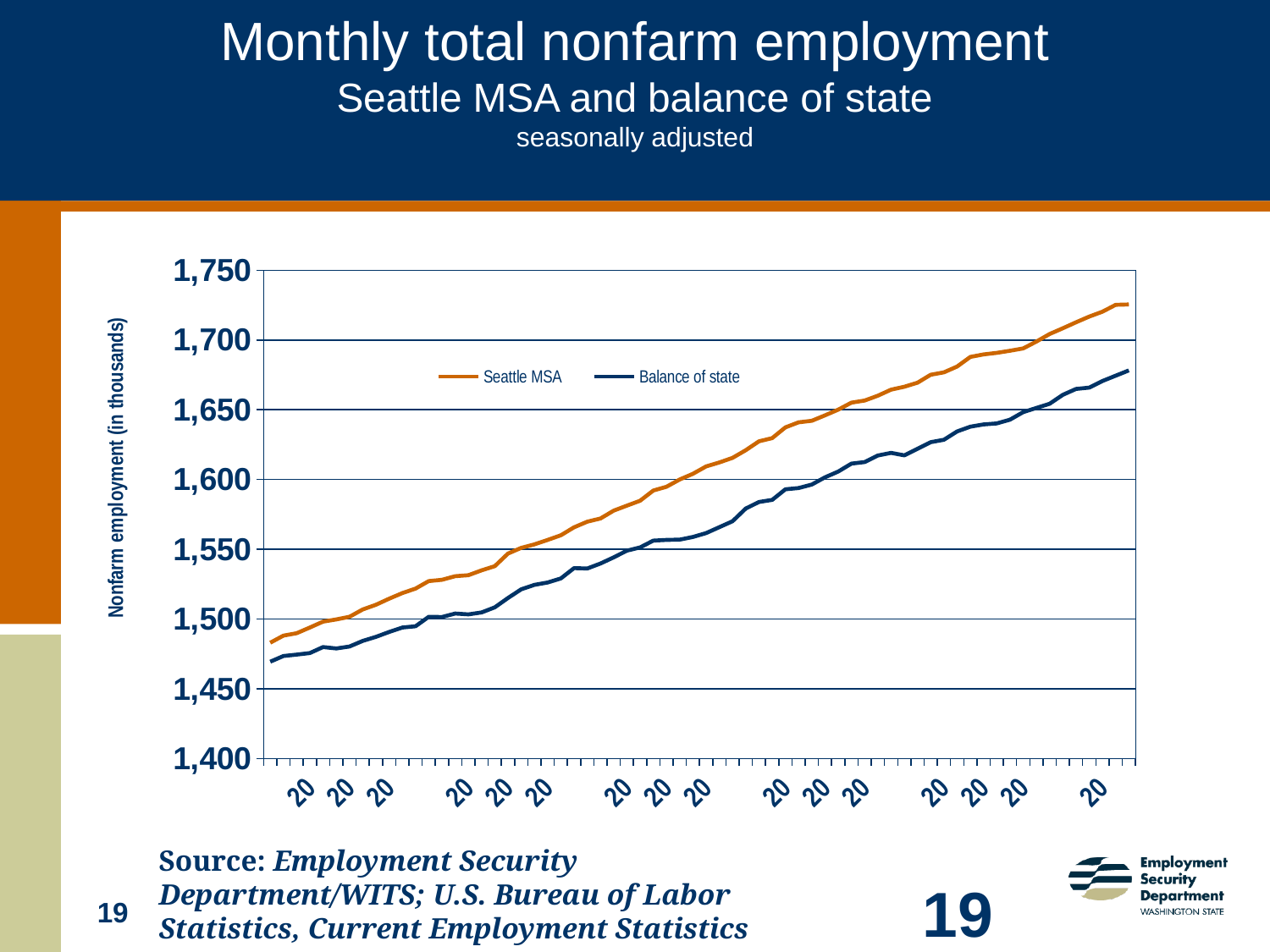
Is the first value for Seattle MSA greater or less than 1,500? less Is the final value for Seattle MSA greater or less than 1,700? greater Is the final value for Balance of state greater or less than 1,650? greater What is the label on the vertical axis? Nonfarm employment (in thousands) Which two series are listed in the legend? Seattle MSA and Balance of state Do the values for Balance of state rise or fall along the x axis? rise How many series does the legend list? 2 Which series reaches the highest value on the chart? Seattle MSA Which series has the lowest value on the chart? Balance of state What kind of chart is shown on the slide? line chart Do the values for Seattle MSA rise or fall along the x axis? rise Which series has the higher values throughout the chart, Seattle MSA or Balance of state? Seattle MSA